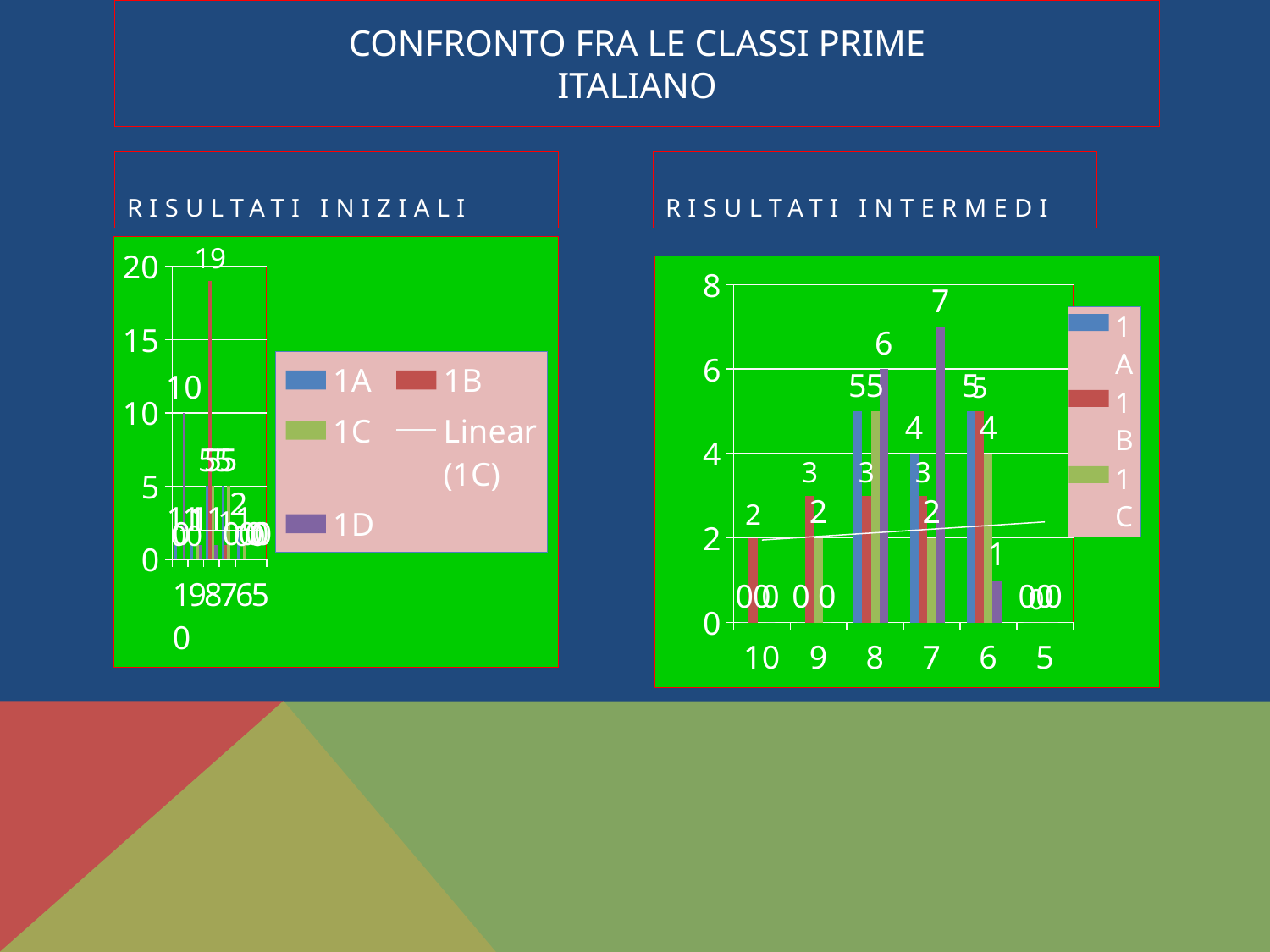
In the 'RISULTATI INIZIALI' chart, what is the highest value labelled on any bar? 19 In the 'RISULTATI INTERMEDI' chart, what is the highest value labelled on any bar? 7 What kind of chart is the 'RISULTATI INTERMEDI' chart? bar chart What is the title of the chart on the left of the slide? RISULTATI INIZIALI In the 'RISULTATI INTERMEDI' chart, how many categories are shown on the x axis? 6 In the 'RISULTATI INIZIALI' chart, how many entries does the legend list? 5 In the 'RISULTATI INTERMEDI' chart, what is the value for 1B at category 9? 3 In the 'RISULTATI INTERMEDI' chart, what is the difference between 1A and 1B at category 8? 2 In the 'RISULTATI INTERMEDI' chart, what is the value for 1C at category 6? 4 In the 'RISULTATI INTERMEDI' chart, what is the value for 1B at category 10? 2 In the 'RISULTATI INTERMEDI' chart, at category 7, which is larger: 1A or 1B? 1A In the 'RISULTATI INTERMEDI' chart, what is the value for 1A at category 8? 5